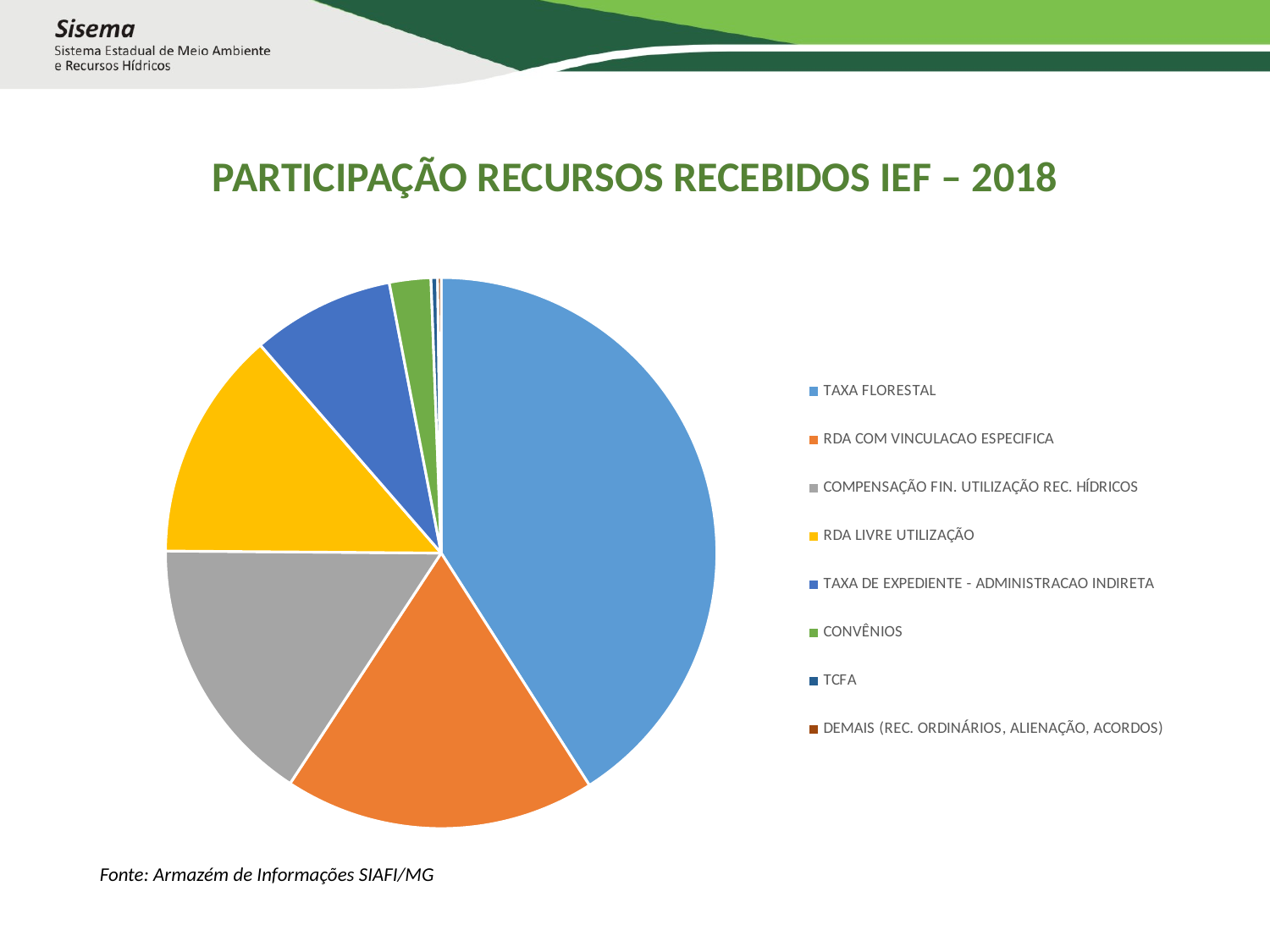
Which slice is larger, COMPENSAÇÃO FIN. UTILIZAÇÃO REC. HÍDRICOS or RDA LIVRE UTILIZAÇÃO? COMPENSAÇÃO FIN. UTILIZAÇÃO REC. HÍDRICOS Which slice is larger, TAXA FLORESTAL or COMPENSAÇÃO FIN. UTILIZAÇÃO REC. HÍDRICOS? TAXA FLORESTAL Which category has the largest slice of the pie? TAXA FLORESTAL How many categories does the legend of the pie chart list? 8 What kind of chart is shown on the slide? pie chart What colour is the TAXA FLORESTAL slice in the pie chart? blue Which slice is larger, TAXA FLORESTAL or RDA COM VINCULACAO ESPECIFICA? TAXA FLORESTAL What is the title of the chart? PARTICIPAÇÃO RECURSOS RECEBIDOS IEF – 2018